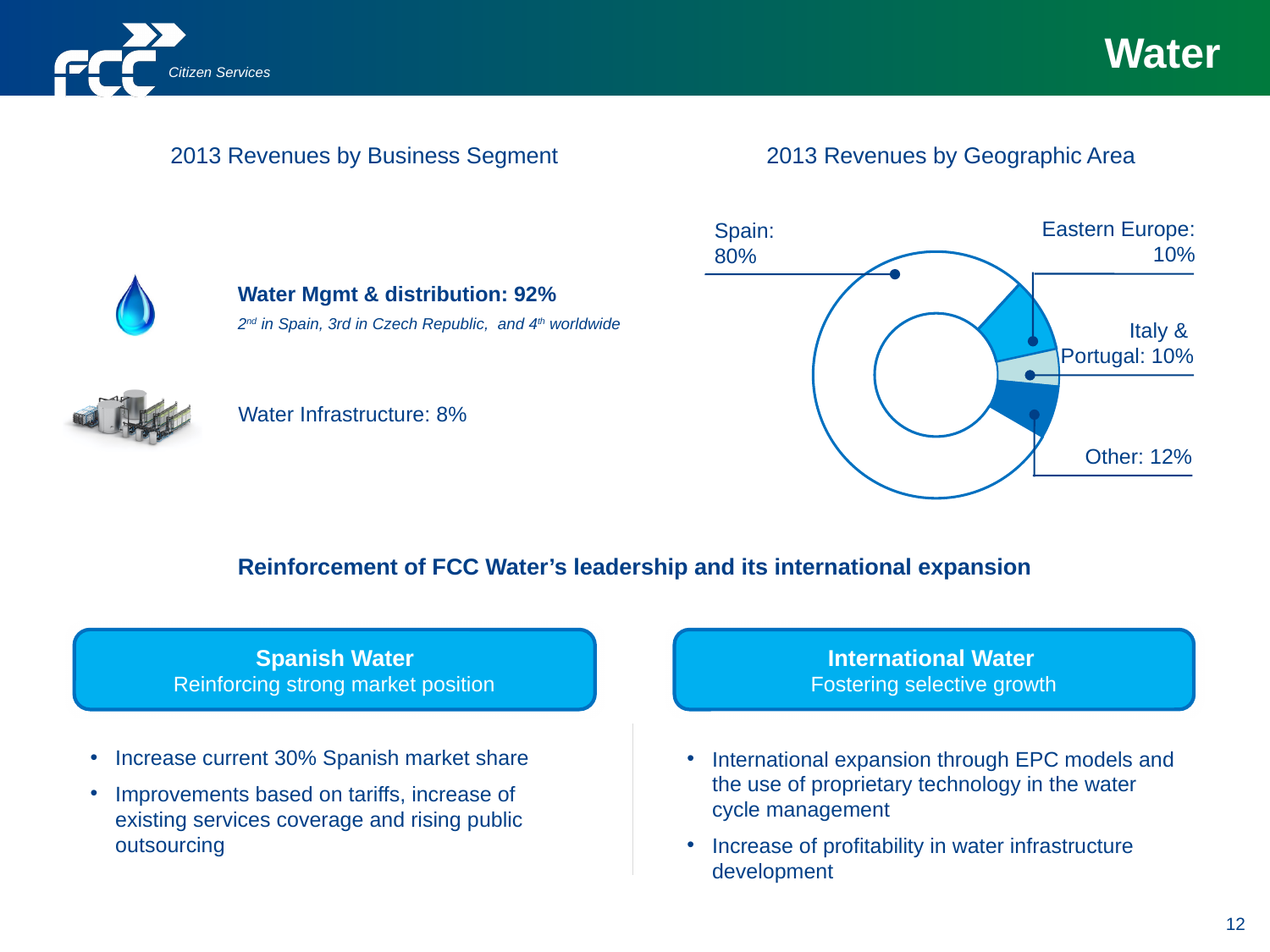
In the 2013 Revenues by Geographic Area chart, what is the difference in percentage points between the Other share and the Italy & Portugal share? 2% In the 2013 Revenues by Geographic Area chart, what share of revenues comes from Eastern Europe? 10% In the 2013 Revenues by Geographic Area chart, which geographic area has the largest share of revenues? Spain In the 2013 Revenues by Geographic Area chart, what is the difference in percentage points between Spain's share and the Other share? 68% In the 2013 Revenues by Geographic Area chart, what share of revenues comes from Spain? 80% In the 2013 Revenues by Geographic Area chart, what share of revenues is labelled Other? 12% What type of chart is used for 2013 Revenues by Geographic Area? Doughnut (pie) chart How many geographic areas are shown in the 2013 Revenues by Geographic Area chart? 4 In the 2013 Revenues by Geographic Area chart, what share of revenues comes from Italy & Portugal? 10% What is the title of the chart on the right side of the slide? 2013 Revenues by Geographic Area In the 2013 Revenues by Geographic Area chart, which is larger: the share for Other or the share for Eastern Europe? Other In the 2013 Revenues by Geographic Area chart, is Spain's share greater or less than 50%? greater